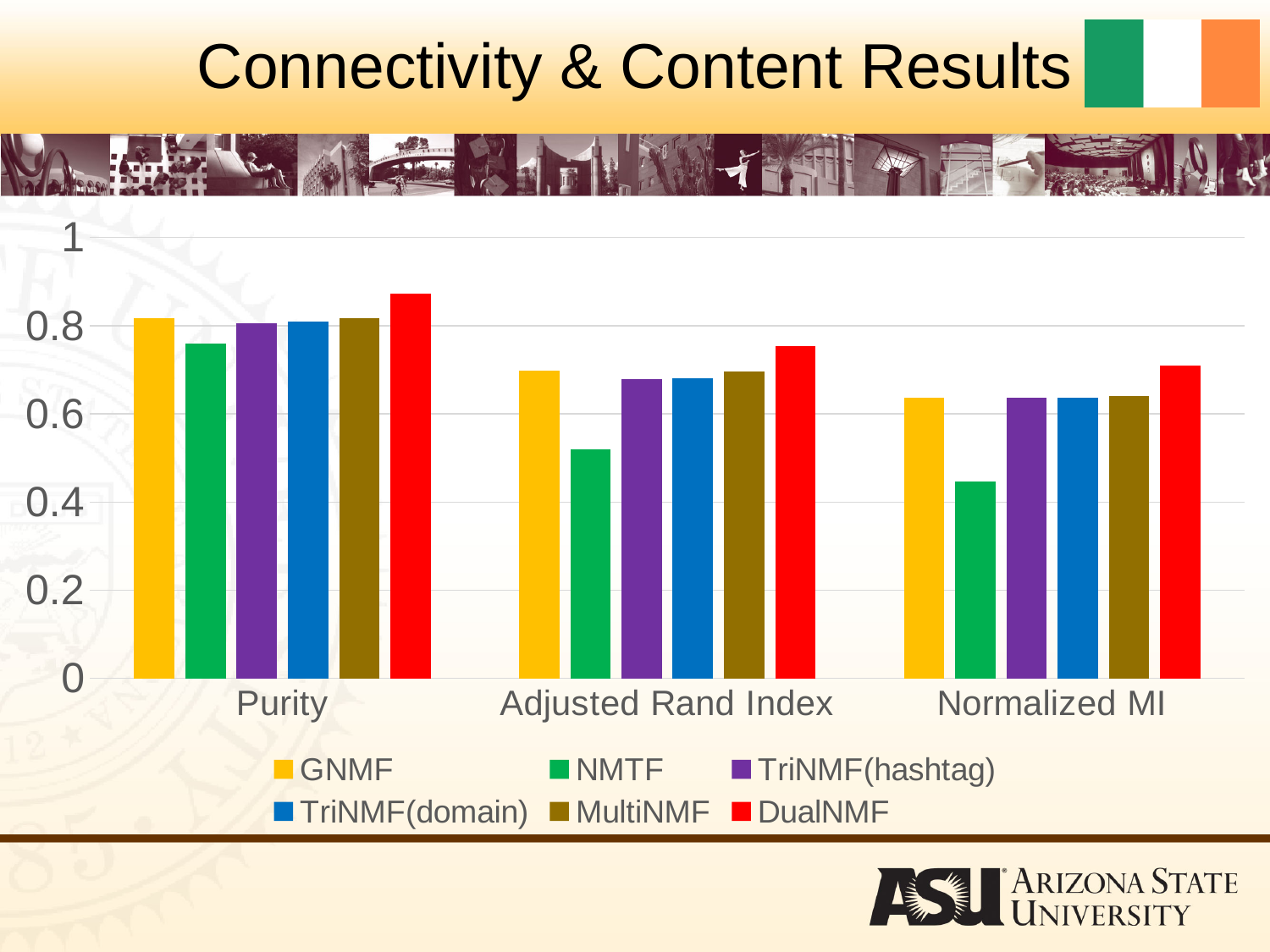
Is the value for NMTF on Adjusted Rand Index greater or less than 0.6? less Which colour represents DualNMF in the legend? red Is the value for NMTF on Purity greater or less than 0.8? less Is the value for DualNMF on Purity greater or less than 0.8? greater What kind of chart is shown on the slide? bar chart How many series does the legend list? 6 Which method has the highest value for Normalized MI? DualNMF Which method has the lowest value for Adjusted Rand Index? NMTF Which is larger: the NMTF value for Purity or the NMTF value for Adjusted Rand Index? Purity Which method has the highest value for Purity? DualNMF Which method has the lowest value for Normalized MI? NMTF How many categories are shown on the x axis? 3